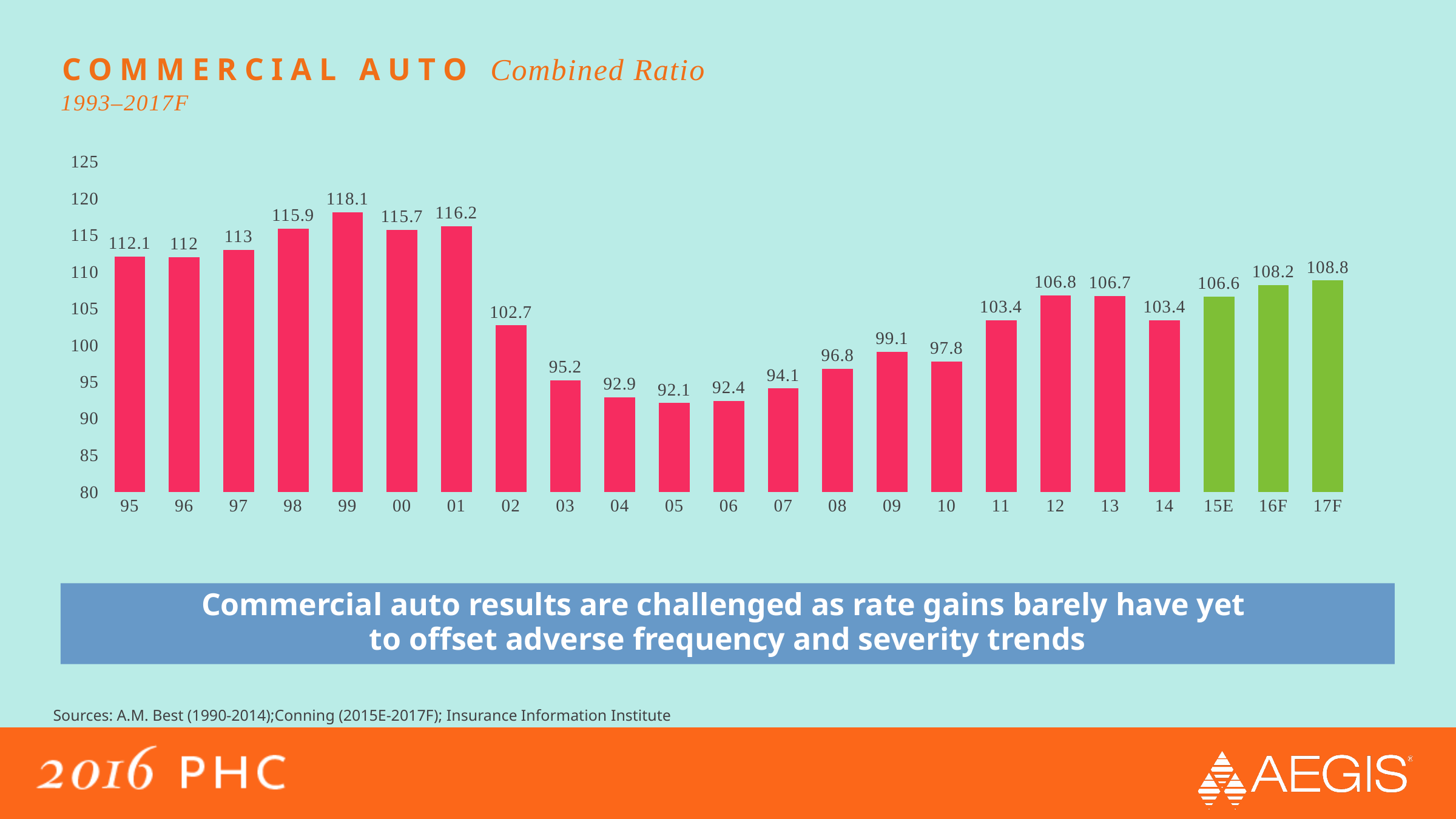
What is the combined ratio forecast for 17F? 108.8 Which year has the highest combined ratio? 99 What type of chart is shown on the slide? Bar chart Which is larger, the combined ratio for 01 or for 00? 01 How many bars are plotted in the chart? 23 Which year has the lowest combined ratio? 05 What is the combined ratio for 99? 118.1 Do the combined ratio values rise or fall from 14 to 17F? Rise What is the difference between the combined ratio for 17F and for 15E? 2.2 What is the combined ratio for 02? 102.7 What is the difference between the combined ratio for 99 and for 05? 26 What is the combined ratio for 05? 92.1